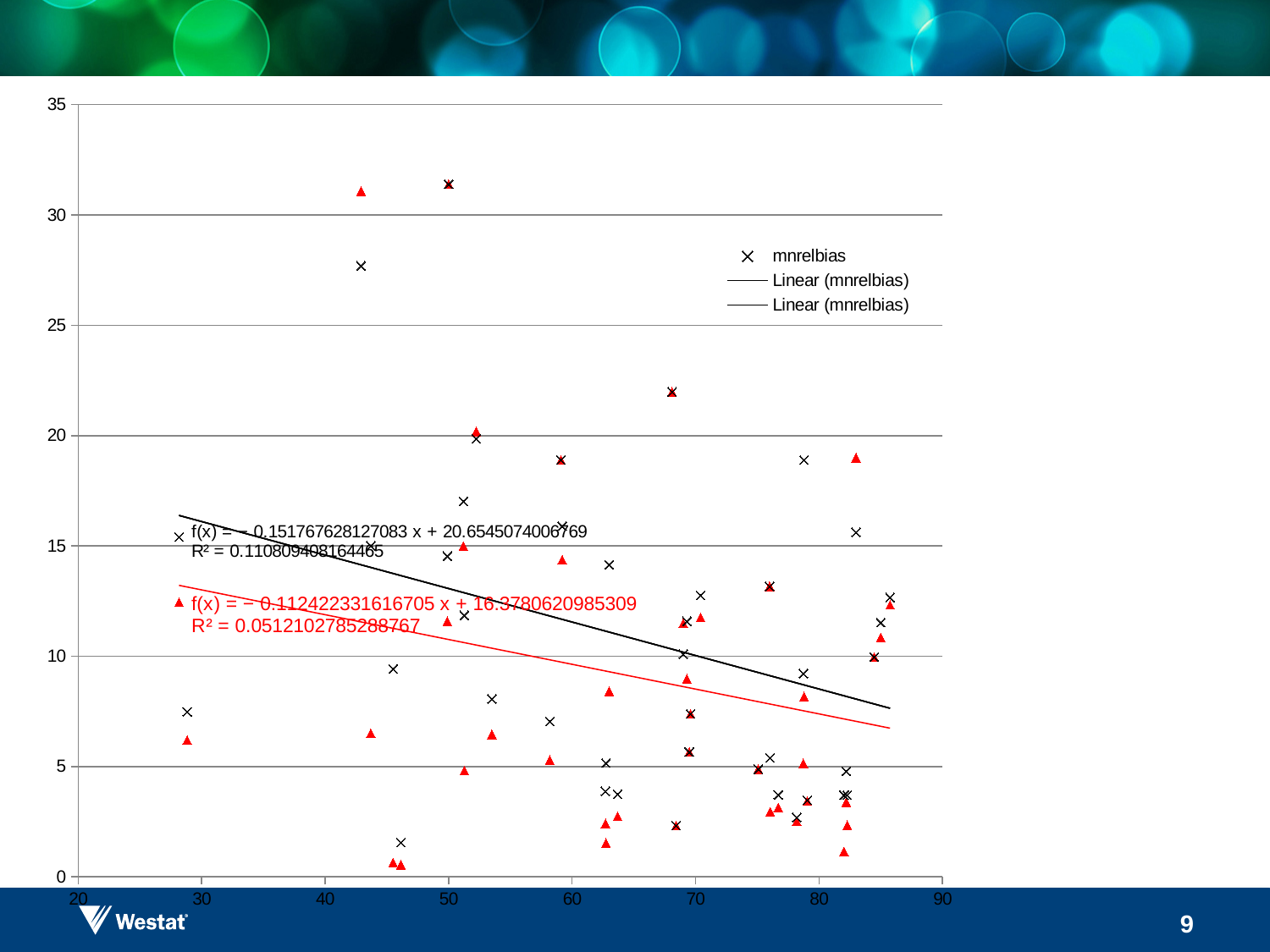
Do the fitted trendlines rise or fall as x increases? fall What kind of chart is shown on the slide? scatter chart How many entries does the chart legend list? 3 What is the minimum value shown on the horizontal axis? 20 Is the value of the black trendline at x = 30 greater or less than 15? greater Is the value of the red trendline at x = 85 greater or less than 10? less What is the maximum value shown on the vertical axis? 35 What R² value is shown for the black trendline? 0.110809408164465 Is the highest plotted point on the chart greater or less than 30? greater What is the name of the series plotted with x markers, as given in the legend? mnrelbias Which trendline has the higher R² value, the black one or the red one? black